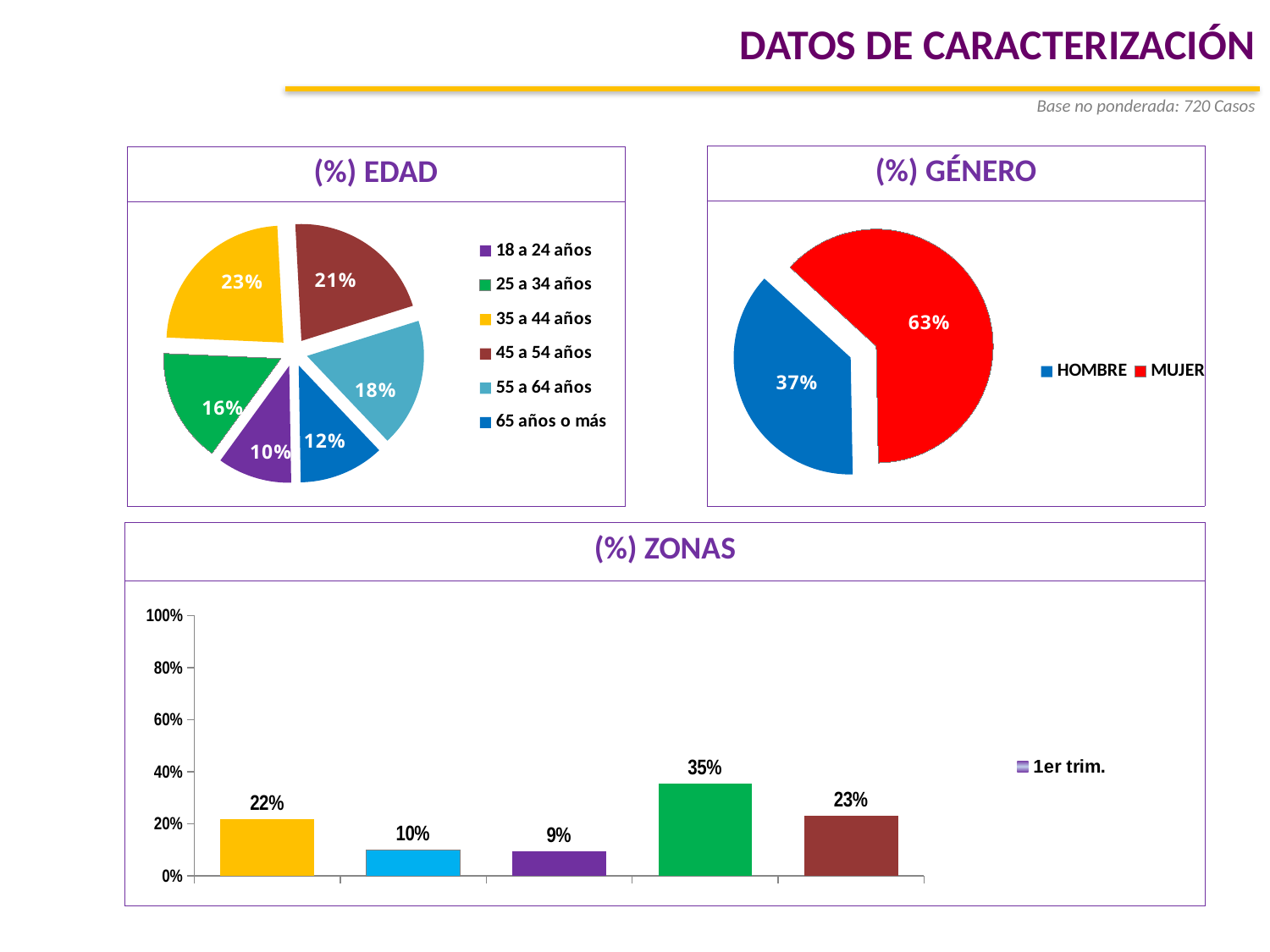
In the (%) EDAD chart, what share is shown for 65 años o más? 12% In the (%) EDAD chart, what is the difference between the shares for 45 a 54 años and 25 a 34 años? 5% In the (%) GÉNERO chart, which category is larger, HOMBRE or MUJER? MUJER In the (%) ZONAS chart, what is the highest value shown on any bar? 35% In the (%) EDAD chart, which age group has the largest share? 35 a 44 años In the (%) EDAD chart, how many age groups does the legend list? 6 In the (%) ZONAS chart, how many bars are plotted? 5 In the (%) EDAD chart, which age group has the smallest share? 18 a 24 años What kind of chart is the (%) GÉNERO chart? Pie chart What kind of chart is the (%) ZONAS chart? Bar chart In the (%) EDAD chart, what share is shown for 35 a 44 años? 23% In the (%) GÉNERO chart, what share is shown for HOMBRE? 37%